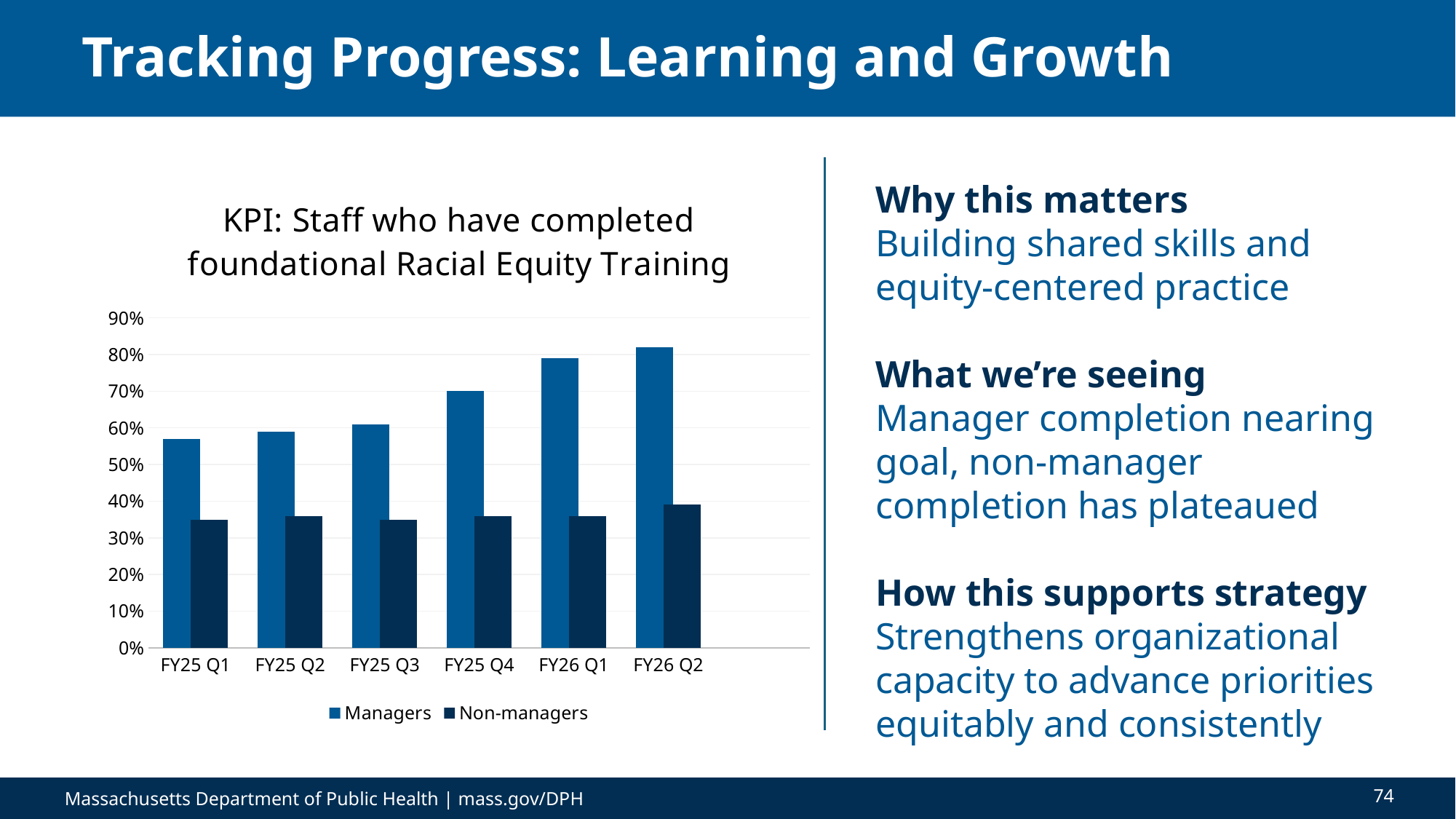
In which quarter is the Non-managers value highest? FY26 Q2 Do the Managers values rise or fall from FY25 Q1 to FY26 Q2? Rise How many series does the legend list? 2 Is the Managers value for FY25 Q4 greater or less than 60%? greater Is the Non-managers value for FY25 Q1 greater or less than 40%? less What is the title of the chart? KPI: Staff who have completed foundational Racial Equity Training How many quarters are shown on the x axis? 6 For Managers, which is larger: FY25 Q1 or FY26 Q1? FY26 Q1 What kind of chart is shown on the slide? Bar chart Is the Managers value for FY26 Q1 greater or less than 70%? greater In FY25 Q1, which is larger: Managers or Non-managers? Managers In which quarter is the Managers value highest? FY26 Q2